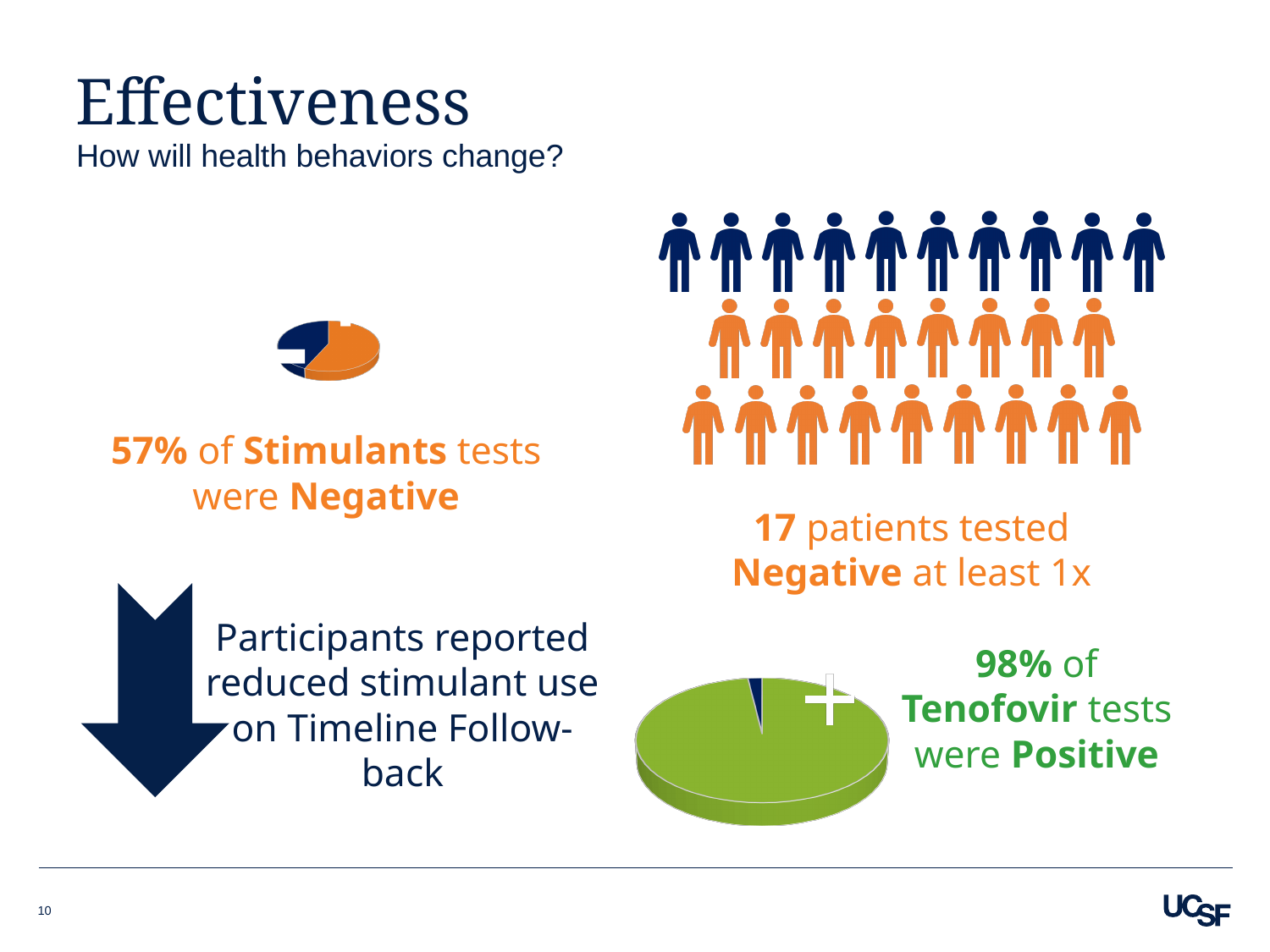
What colour is the large slice in the Tenofovir pie chart? green What kind of chart is shown next to the text '98% of Tenofovir tests were Positive'? pie chart What kind of chart is shown next to the text '57% of Stimulants tests were Negative'? pie chart According to the slide, what percentage of Tenofovir tests were Positive? 98% According to the slide, what percentage of Stimulants tests were Negative? 57% According to the people pictogram, how many patients tested Negative at least once? 17 How many percentage points higher is the share of Positive Tenofovir tests than the share of Negative Stimulants tests? 41 Which is larger: the share of Stimulants tests that were Negative or the share of Tenofovir tests that were Positive? Tenofovir tests Positive In the Stimulants pie chart, what share of tests were not Negative? 43% In the Tenofovir pie chart, what share of tests is represented by the small dark slice (the tests that were not Positive)? 2% How many slices does the Tenofovir pie chart have? 2 What colour are the people icons representing patients who tested Negative at least once? orange